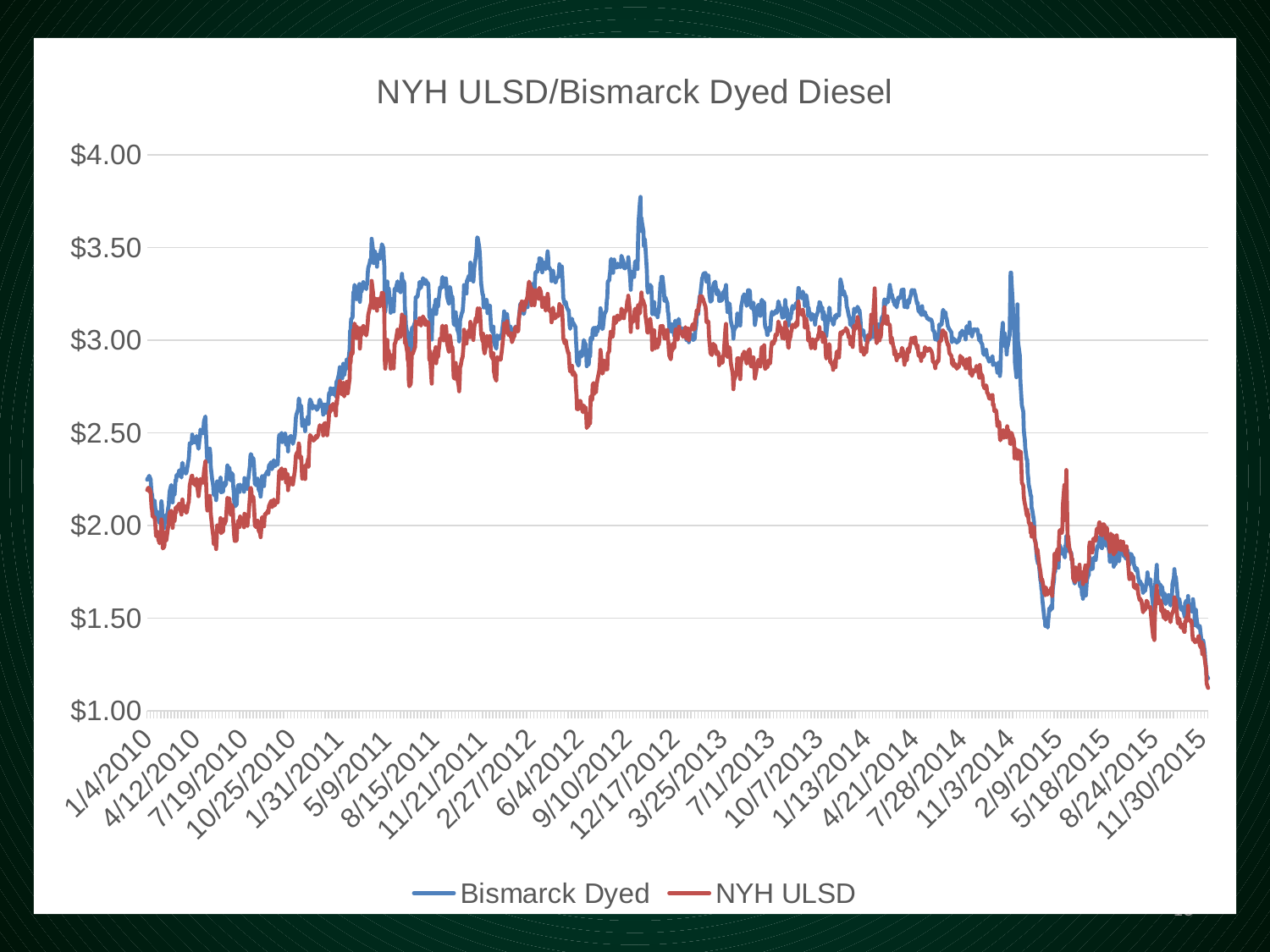
Do the values rise or fall between 1/4/2010 and 5/9/2011? rise How many series does the legend list? 2 Around 9/10/2012, which series has the larger value, Bismarck Dyed or NYH ULSD? Bismarck Dyed Is the value for Bismarck Dyed at its peak around 9/10/2012 greater or less than $3.50? greater Which series reaches the highest value on the chart? Bismarck Dyed Is the value for Bismarck Dyed at 10/7/2013 greater or less than $3.00? greater What kind of chart is shown on the slide? line chart What colour is the NYH ULSD line? red What is the title of the chart? NYH ULSD/Bismarck Dyed Diesel Do the values rise or fall between 7/28/2014 and 11/30/2015? fall Is the value for NYH ULSD at 8/24/2015 greater or less than $2.00? less